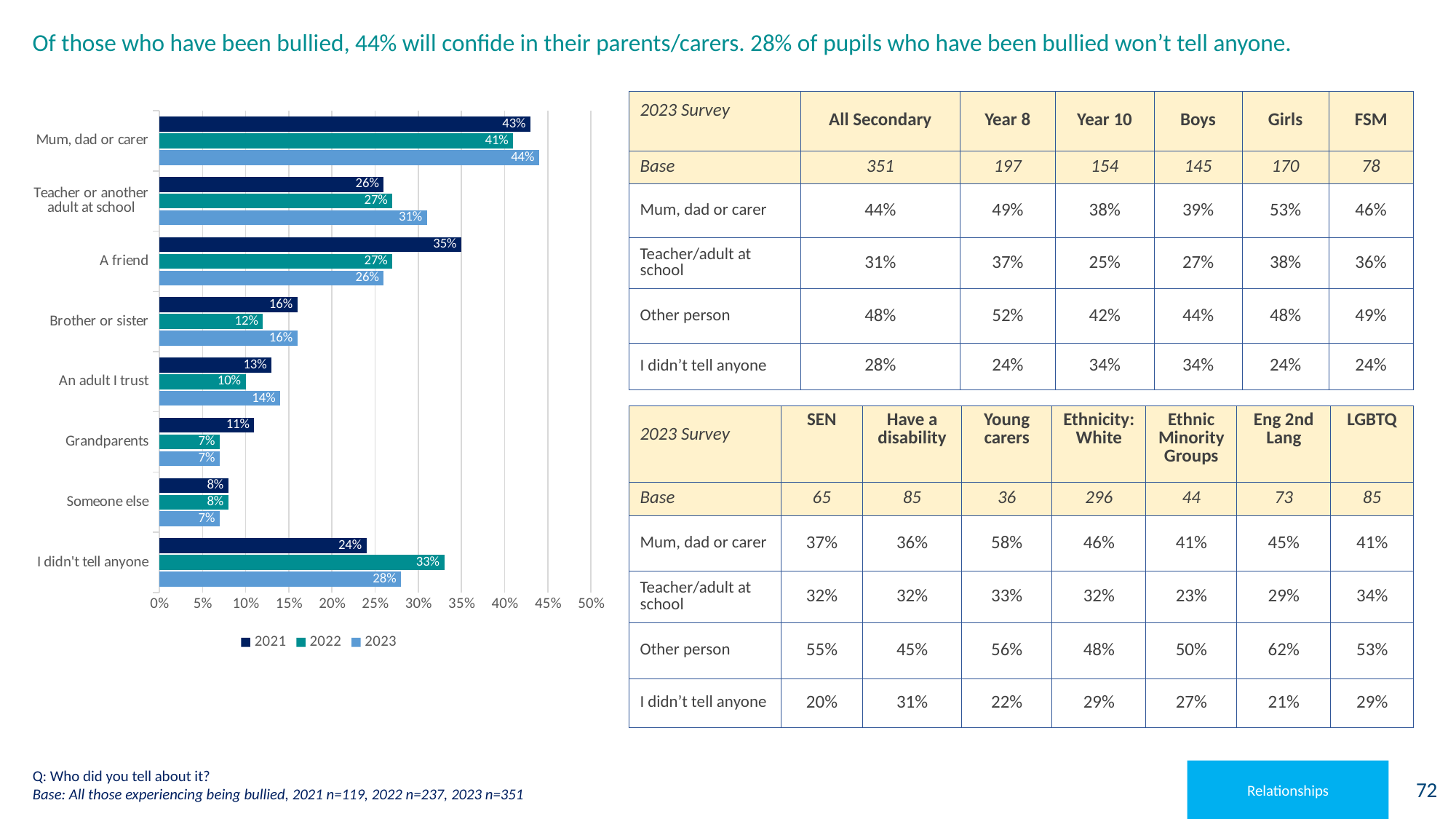
Did the value for 'Grandparents' rise or fall from 2021 to 2022 in the chart? fall What is the difference between the 2021 and 2023 values for 'Teacher or another adult at school' in the chart? 5% What is the 2021 value for 'Brother or sister' in the chart? 16% Which category has the highest 2023 value in the chart? Mum, dad or carer What is the 2022 value for 'I didn't tell anyone' in the chart? 33% In the chart, which is larger for 'A friend': the 2021 value or the 2022 value? 2021 How many series does the chart legend list? 3 Which category has the lowest 2021 value in the chart? Someone else How many categories are shown on the chart? 8 What is the 2023 value for 'A friend' in the chart? 26% What kind of chart is shown on the slide? bar chart Which series in the chart legend is shown in the darkest blue colour? 2021